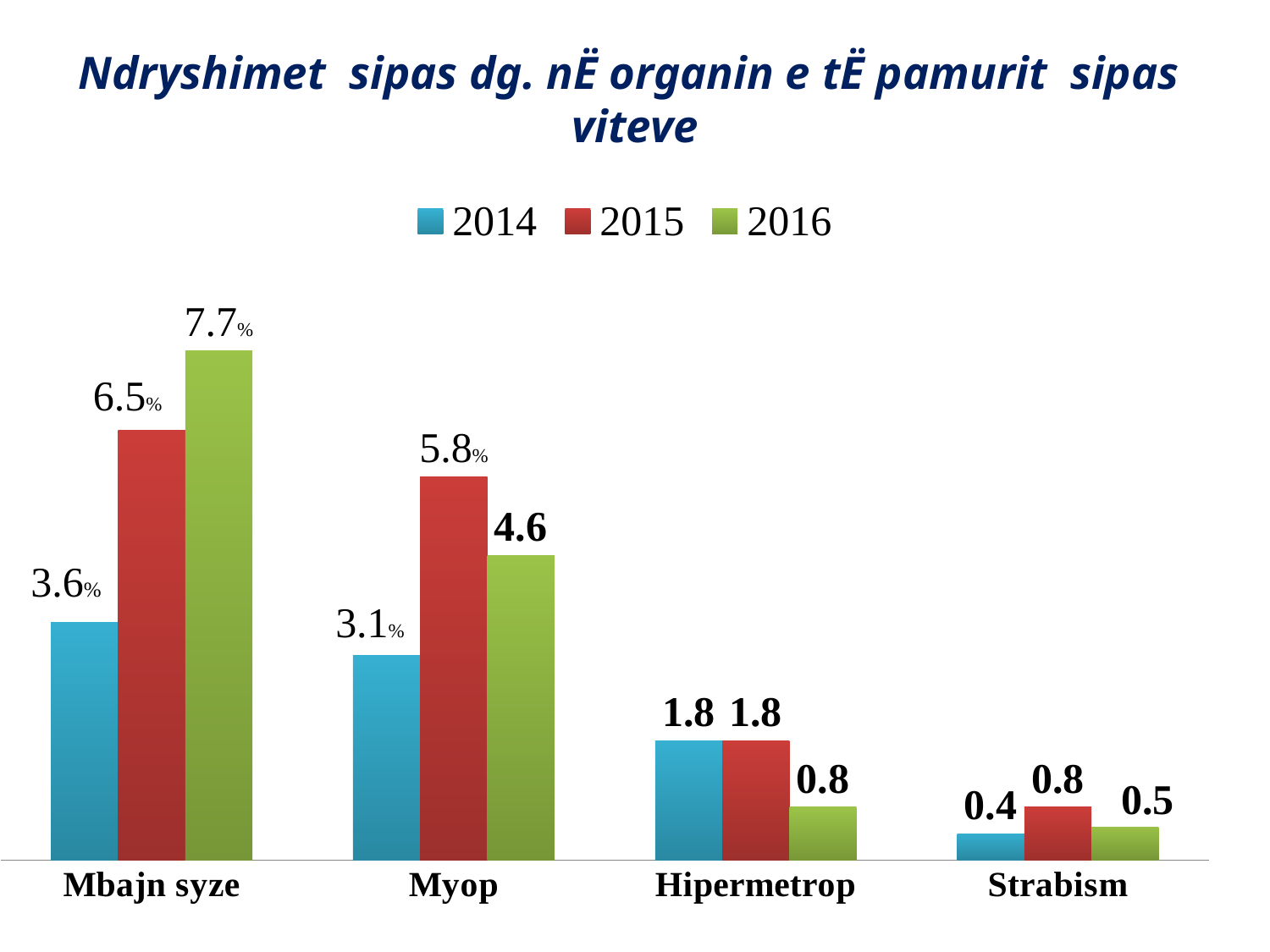
What is the difference between the 2016 and 2014 values for Mbajn syze? 4.1 What is the value for Hipermetrop in 2016? 0.8 Which category has the lowest value in 2014? Strabism How many categories are shown on the x axis? 4 How many series does the legend list? 3 What is the value for Strabism in 2014? 0.4 Which category has the highest value in 2016? Mbajn syze What is the value for Mbajn syze in 2016? 7.7% Which colour represents 2015 in the legend? Red What is the value for Myop in 2015? 5.8% What kind of chart is shown on the slide? Bar chart Which is larger for Myop: the 2015 value or the 2016 value? 2015